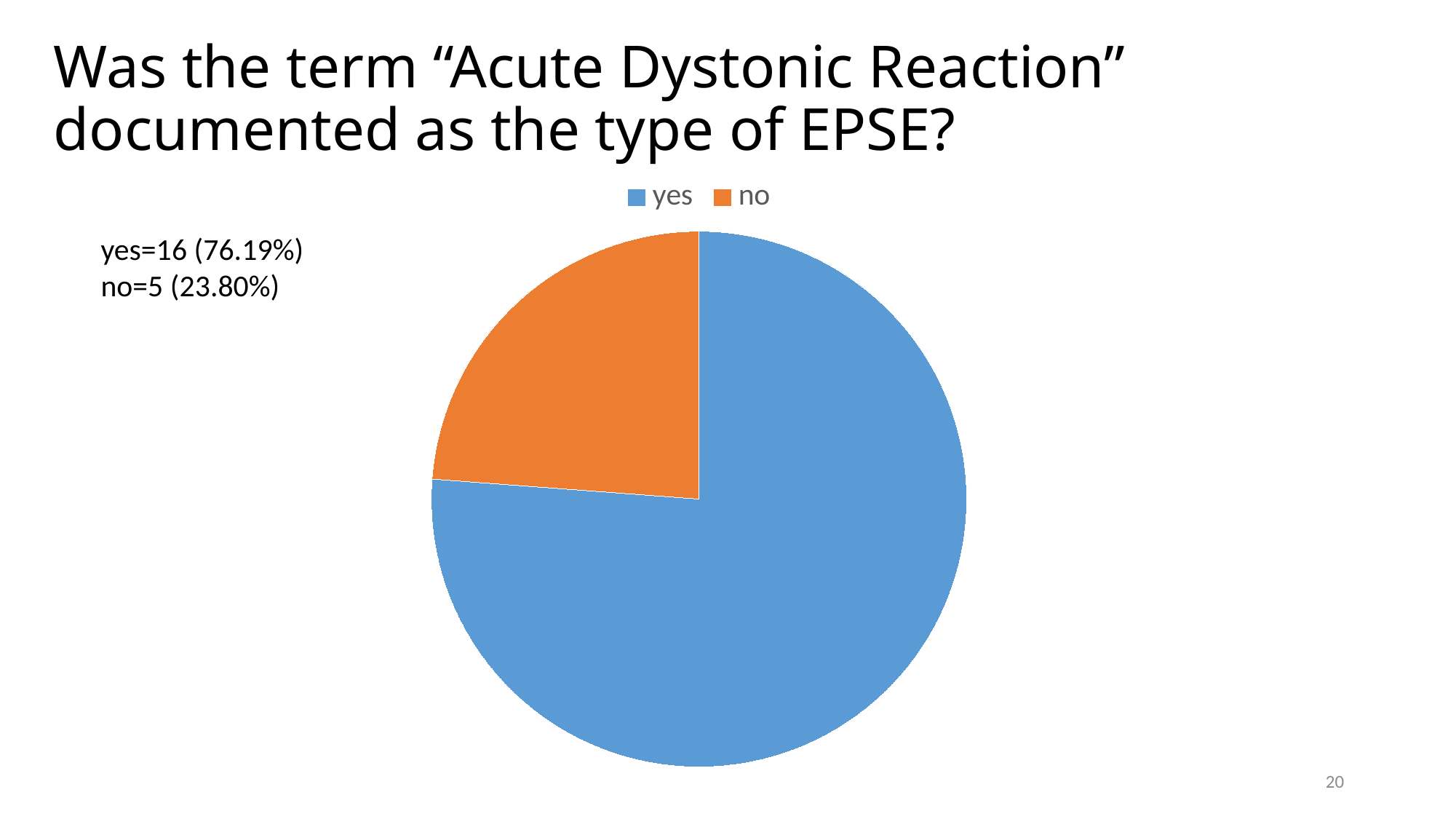
What colour is the "no" slice? orange What is the difference between the counts for "yes" and "no"? 11 How many slices does the pie chart have? 2 What is the count for "no"? 5 Which category has the smallest slice? no What is the count for "yes"? 16 What percentage share does the "yes" slice represent? 76.19% Which category has the largest slice? yes Which is larger, the "yes" slice or the "no" slice? yes What percentage share does the "no" slice represent? 23.80% What kind of chart is shown on the slide? pie chart How many entries does the legend list? 2